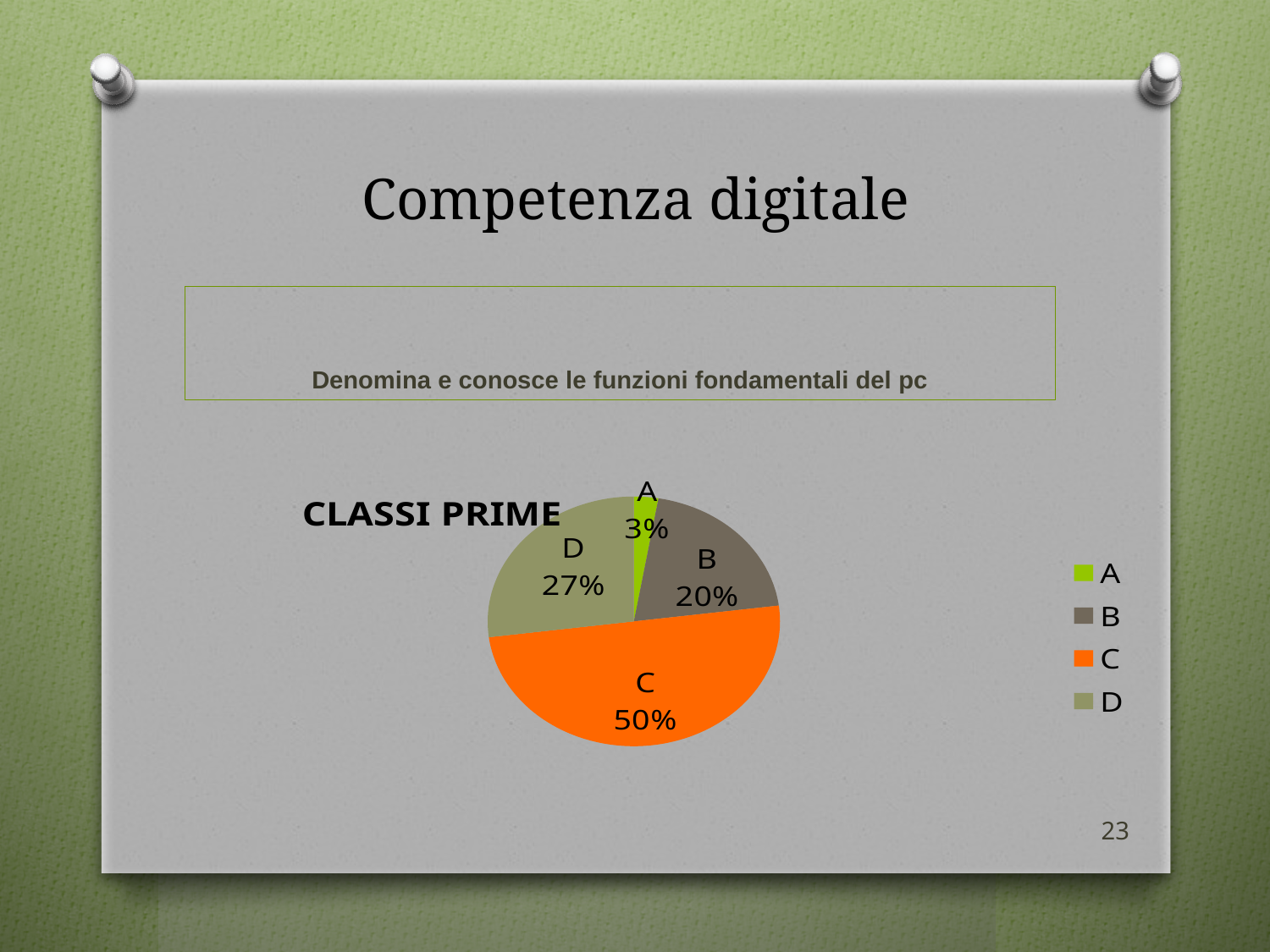
What kind of chart is shown on the slide? pie chart What is the difference in percentage points between slice C and slice D? 23 What percentage does slice A represent? 3% Which is larger, the share for B or the share for D? D What percentage does slice C represent? 50% What percentage does slice D represent? 27% What percentage does slice B represent? 20% What is the title of the chart? CLASSI PRIME How many slices does the pie chart have? 4 Which category has the largest share of the pie? C Which category has the smallest share of the pie? A How many entries does the legend list? 4